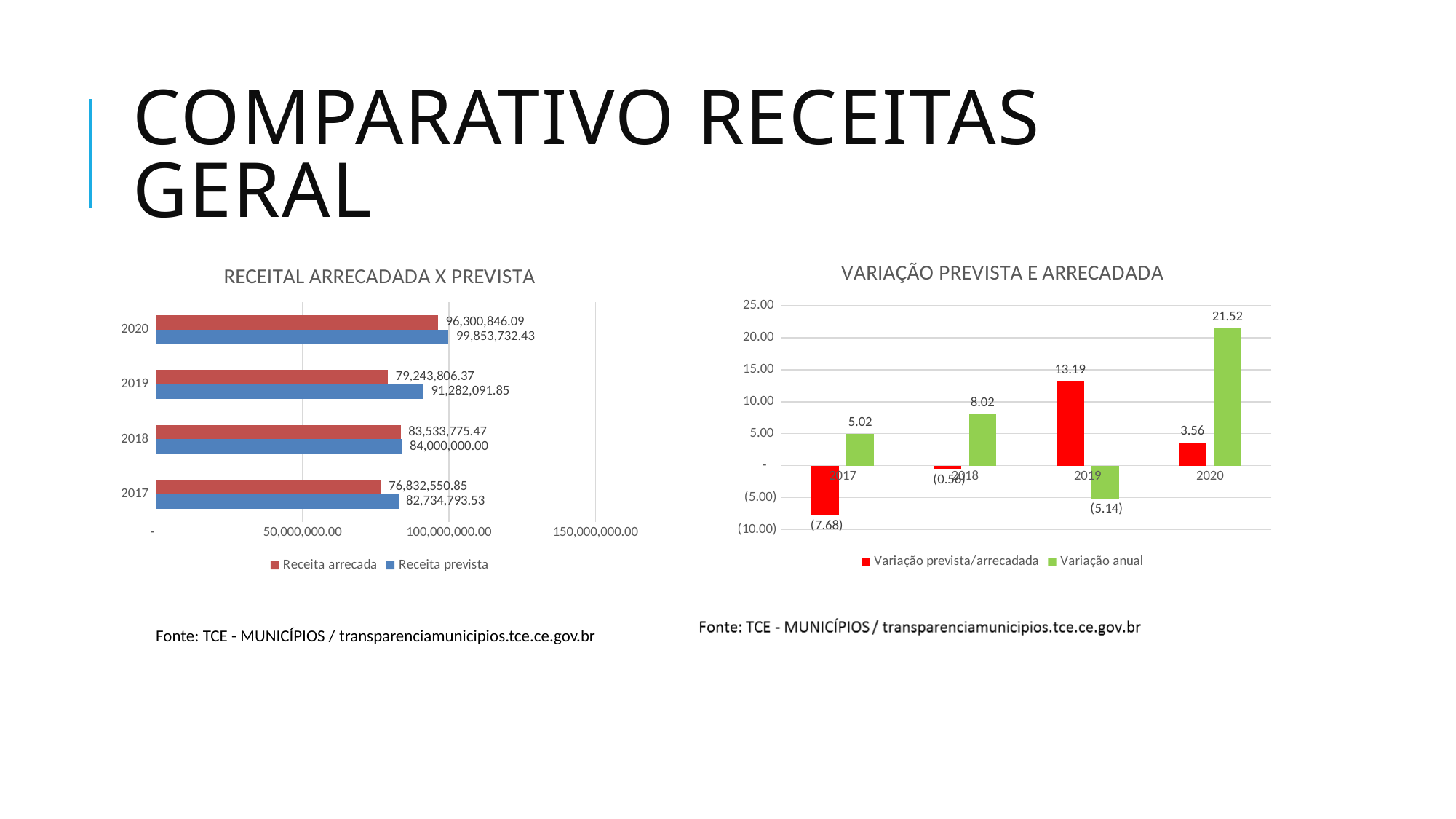
In the chart titled VARIAÇÃO PREVISTA E ARRECADADA, how many years are shown on the x axis? 4 In the chart titled VARIAÇÃO PREVISTA E ARRECADADA, what is the Variação anual value for 2020? 21.52 In the chart titled VARIAÇÃO PREVISTA E ARRECADADA, which is larger for 2019: Variação prevista/arrecadada or Variação anual? Variação prevista/arrecadada In the chart titled RECEITAL ARRECADADA X PREVISTA, what is the Receita prevista value for 2020? 99,853,732.43 In the chart titled RECEITAL ARRECADADA X PREVISTA, how many series does the legend list? 2 In the chart titled VARIAÇÃO PREVISTA E ARRECADADA, what is the Variação prevista/arrecadada value for 2017? (7.68) In the chart titled VARIAÇÃO PREVISTA E ARRECADADA, which year has the lowest Variação anual? 2019 In the chart titled RECEITAL ARRECADADA X PREVISTA, what is the difference between Receita prevista and Receita arrecadada for 2018? 466,224.53 In the chart titled RECEITAL ARRECADADA X PREVISTA, is the Receita arrecadada for 2019 greater or less than 100,000,000.00? less In the chart titled RECEITAL ARRECADADA X PREVISTA, which year has the highest Receita arrecadada? 2020 In the chart titled RECEITAL ARRECADADA X PREVISTA, what is the Receita arrecadada value for 2017? 76,832,550.85 What kind of chart is the chart titled RECEITAL ARRECADADA X PREVISTA? bar chart